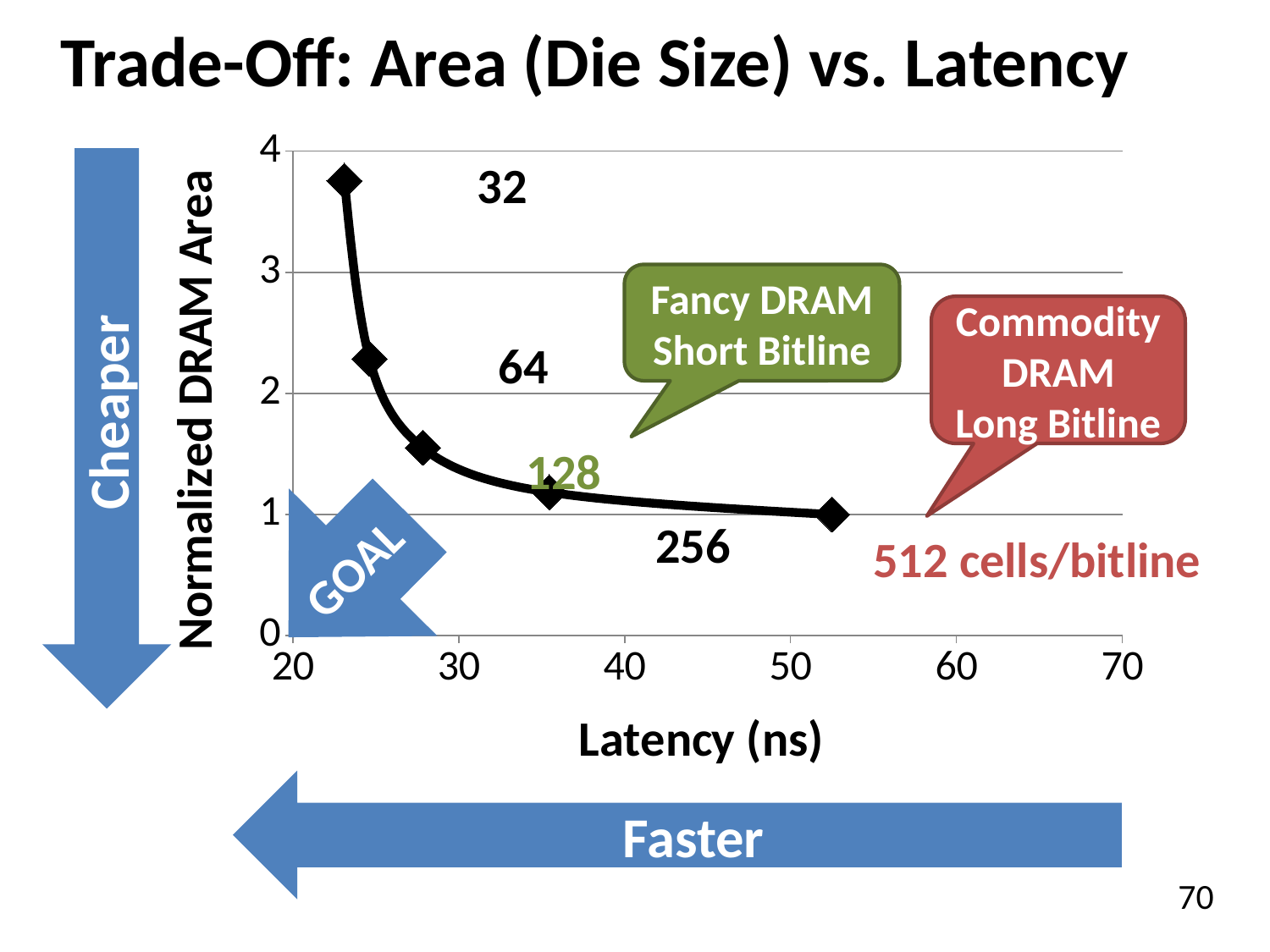
Is the latency for 512 cells/bitline greater or less than 50 ns? greater Which cells/bitline configuration has the lowest normalized DRAM area? 512 Which cells/bitline configuration has the highest normalized DRAM area? 32 What kind of chart is shown on the slide? line chart (scatter with connected points) Is the normalized DRAM area for 32 cells/bitline greater or less than 3? greater What is the title of the x axis? Latency (ns) What is the title of the y axis? Normalized DRAM Area As latency increases along the x axis, does the normalized DRAM area rise or fall? fall Which cells/bitline configuration has the highest latency? 512 Is the normalized DRAM area for 64 cells/bitline greater or less than 2? greater How many data points are plotted on the chart? 5 Which has a larger normalized DRAM area, 128 cells/bitline or 256 cells/bitline? 128 cells/bitline